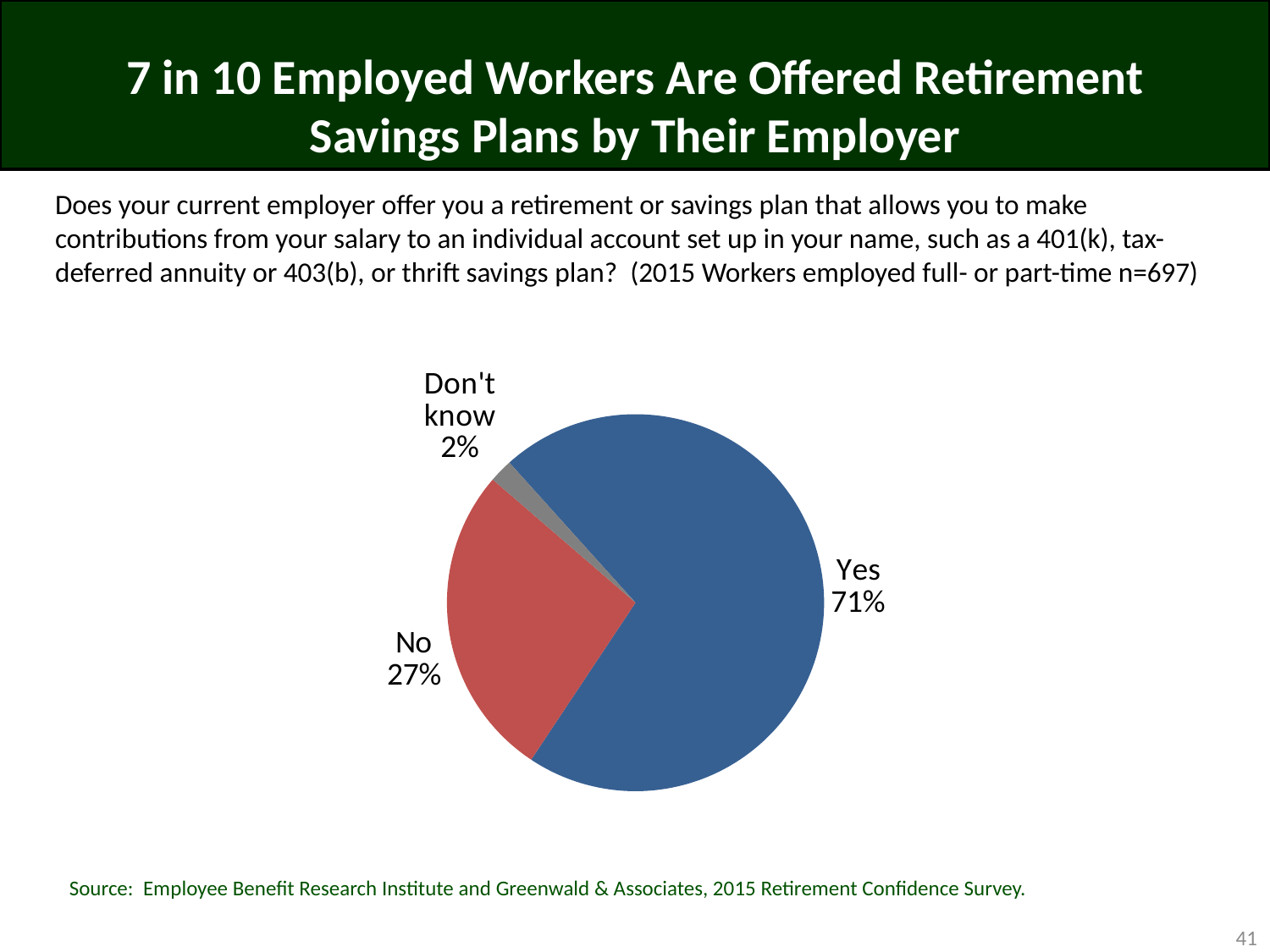
Which response has the smallest share of the pie? Don't know What percentage of workers answered "No"? 27% What is the difference in percentage points between the "Yes" and "No" slices? 44 What is the difference in percentage points between the "No" and "Don't know" slices? 25 What percentage of workers answered "Don't know"? 2% Which is larger, the "No" slice or the "Don't know" slice? No What colour is the "No" slice? Red How many slices does the pie chart have? 3 What colour is the "Yes" slice? Blue What percentage of workers answered "Yes"? 71% Which response has the largest share of the pie? Yes What kind of chart is shown on the slide? Pie chart